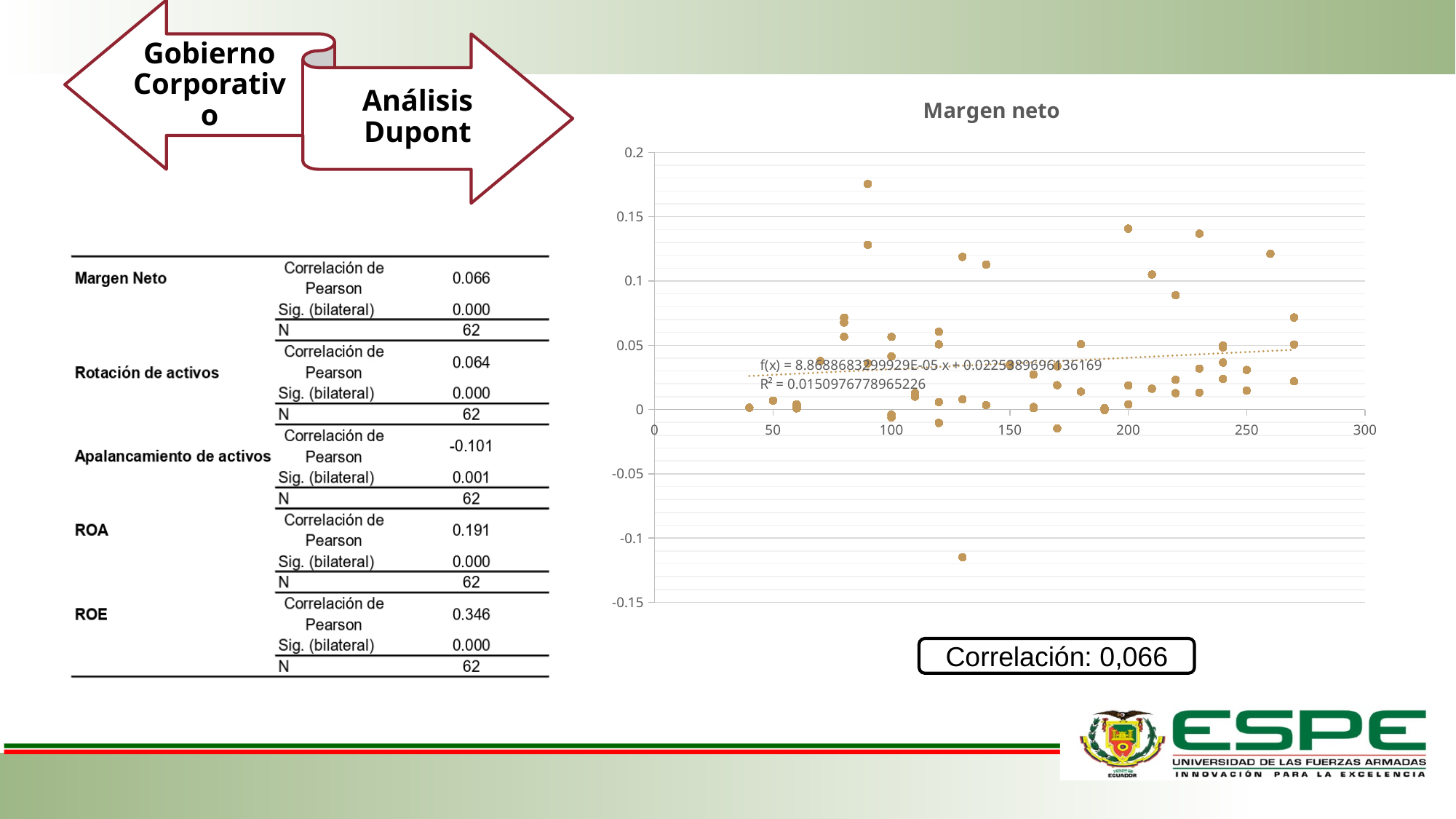
What is the title of the chart on the slide? Margen neto What R² value is printed on the chart's trendline label? R² = 0.0150976778965226 What is the maximum value shown on the x axis of the chart? 300 Does the dotted trendline on the chart rise or fall as x increases? Rises What kind of chart is shown on the slide? Scatter chart Is the lowest point on the chart located at an x value greater or less than 100? greater Is the value of the highest point near x = 200 greater or less than 0.1? greater What correlation value is shown in the box below the chart? 0,066 Is the value of the lowest point on the chart greater or less than -0.1? less